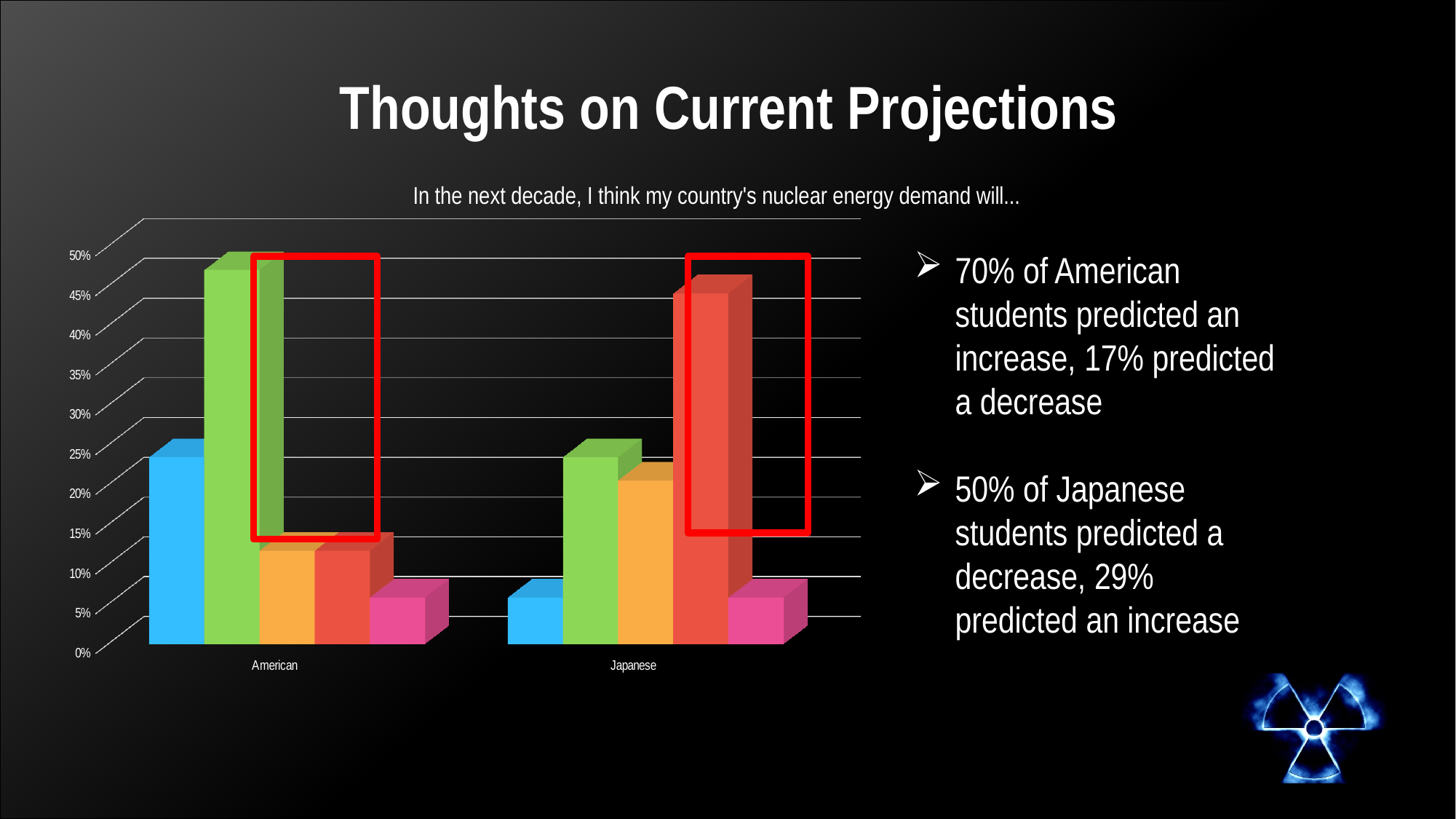
Which coloured bar is the tallest in the Japanese category? red What is the title of the chart? In the next decade, I think my country's nuclear energy demand will... What kind of chart is shown on the slide? bar chart Is the value of the blue bar for Japanese greater or less than 10%? less Which coloured bar is the tallest in the American category? green Which is larger, the blue bar for American or the blue bar for Japanese? American Is the value of the blue bar for American greater or less than 30%? less Which two bars are outlined with red rectangles on the chart? the green bar for American and the red bar for Japanese How many bars are plotted for each category in the chart? 5 How many categories are shown on the x axis of the chart? 2 Is the value of the green bar for American greater or less than 40%? greater